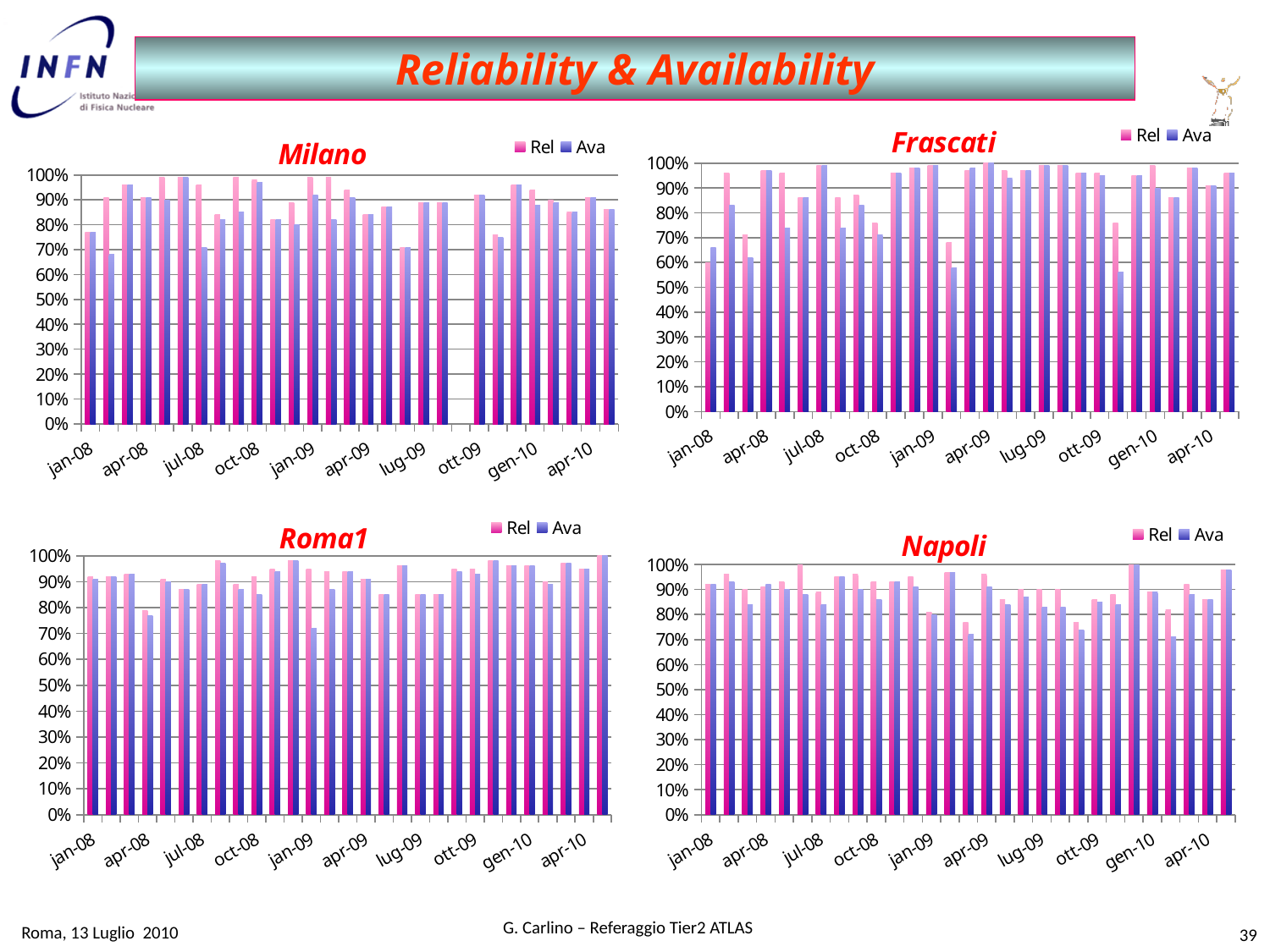
In the Roma1 chart, is the Rel value for apr-10 greater or less than 90%? greater What kind of chart is the Milano chart? bar chart In the Milano chart, is the Rel value for jan-08 greater or less than 90%? less How many charts are shown on the slide? 4 What are the two series named in the legend of the Roma1 chart? Rel and Ava In the Frascati chart, is the Rel value for jan-08 greater or less than 70%? less In the Frascati chart, which is larger for jan-08, the Rel value or the Ava value? Ava In the Milano chart, which is larger for jan-08, the Rel value or the Ava value? Neither; they are equal How many series does the legend of the Frascati chart list? 2